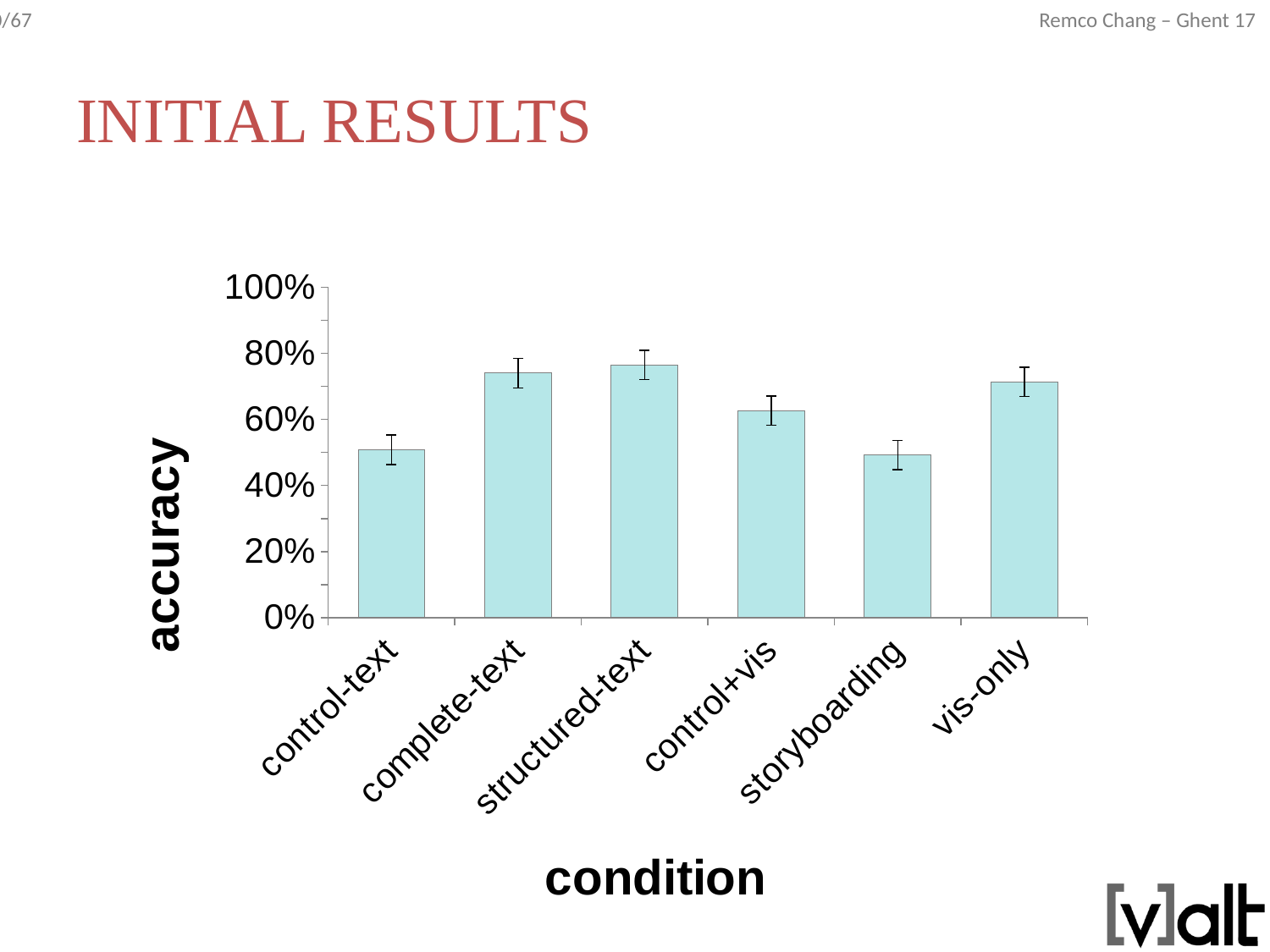
How many conditions are plotted on the x axis of the chart? 6 Which condition has the higher accuracy, vis-only or storyboarding? vis-only Is the accuracy for complete-text greater or less than 60%? greater Is the accuracy for control+vis greater or less than 80%? less What is the label of the horizontal axis of the chart? condition Is the accuracy for control-text greater or less than 40%? greater What is the label of the vertical axis of the chart? accuracy Which condition has the higher accuracy, complete-text or control+vis? complete-text What kind of chart is shown on the slide? bar chart